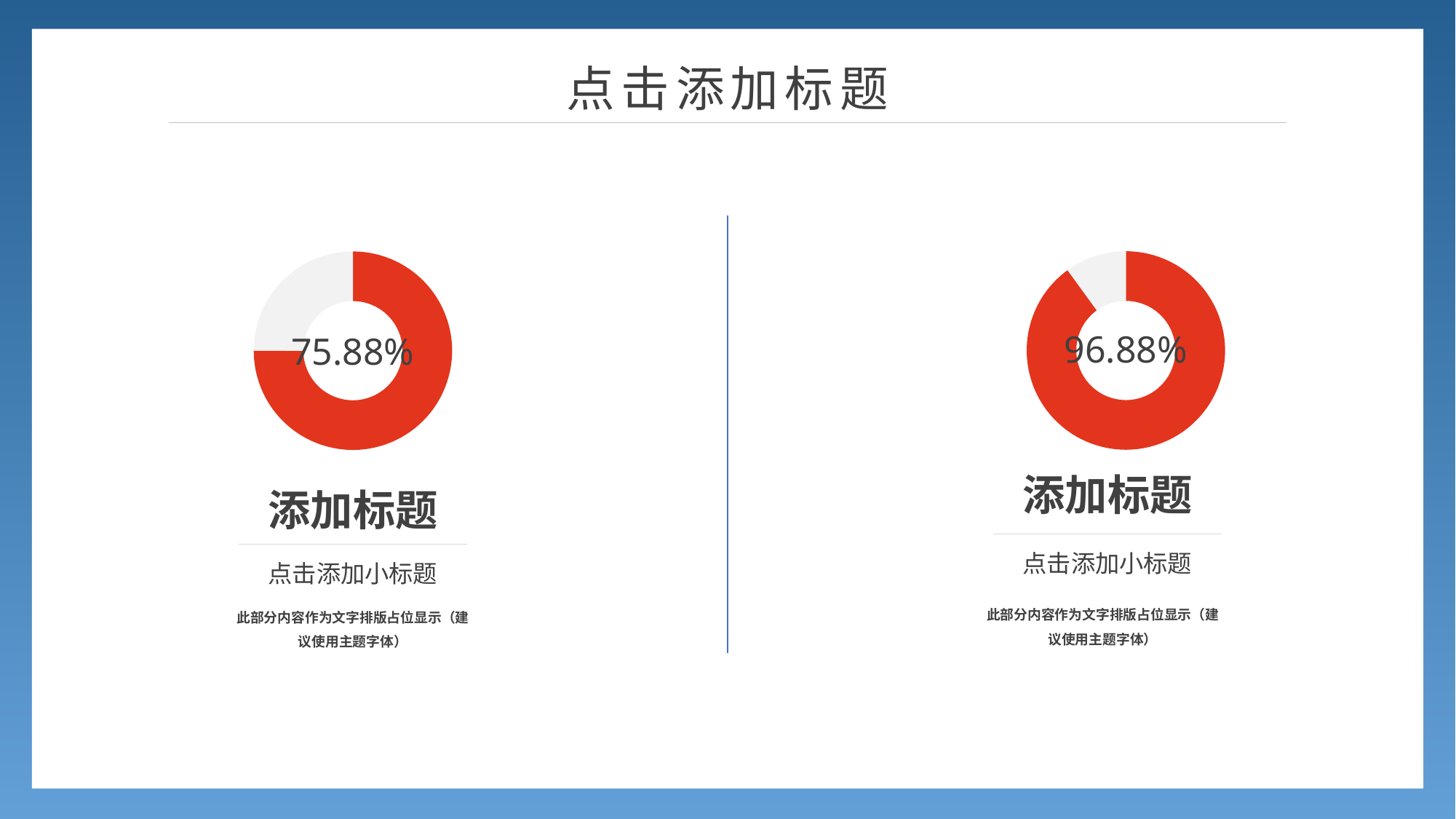
What is the difference between the percentage on the right donut chart and the percentage on the left donut chart? 21.00% What percentage is shown in the centre of the right donut chart? 96.88% Which donut chart shows the larger percentage, the left one or the right one? the right one How many donut charts are on the slide? 2 What kind of chart is used on the left side of the slide? donut chart What colour is the filled portion of the donut charts? red What percentage is shown in the centre of the left donut chart? 75.88% What is the heading text shown below each donut chart? 添加标题